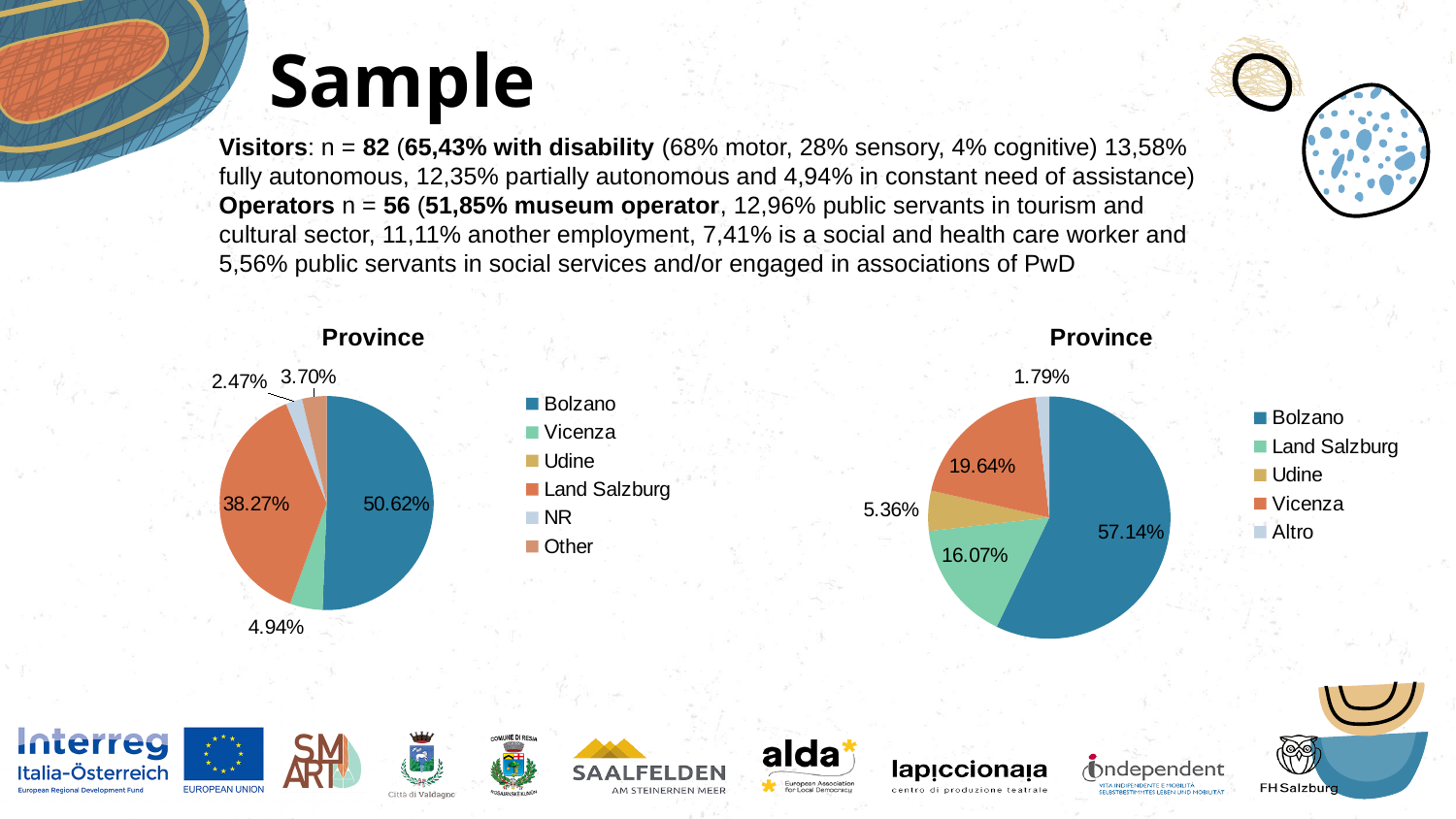
In the left pie chart, what share is Bolzano? 50.62% In the right pie chart, what share is Vicenza? 19.64% In the left pie chart, what share is Land Salzburg? 38.27% How many entries does the legend of the left pie chart list? 6 In the left pie chart, which is larger, the Bolzano share or the Land Salzburg share? Bolzano In the right pie chart, what share is Bolzano? 57.14% In the right pie chart, what is the difference between the Bolzano and Land Salzburg shares? 41.07% In the right pie chart, what share is Udine? 5.36% In the right pie chart, which province has the largest share? Bolzano In the left pie chart, what share is Vicenza? 4.94% In the right pie chart, what share is Altro? 1.79% In the right pie chart, which category has the smallest share? Altro